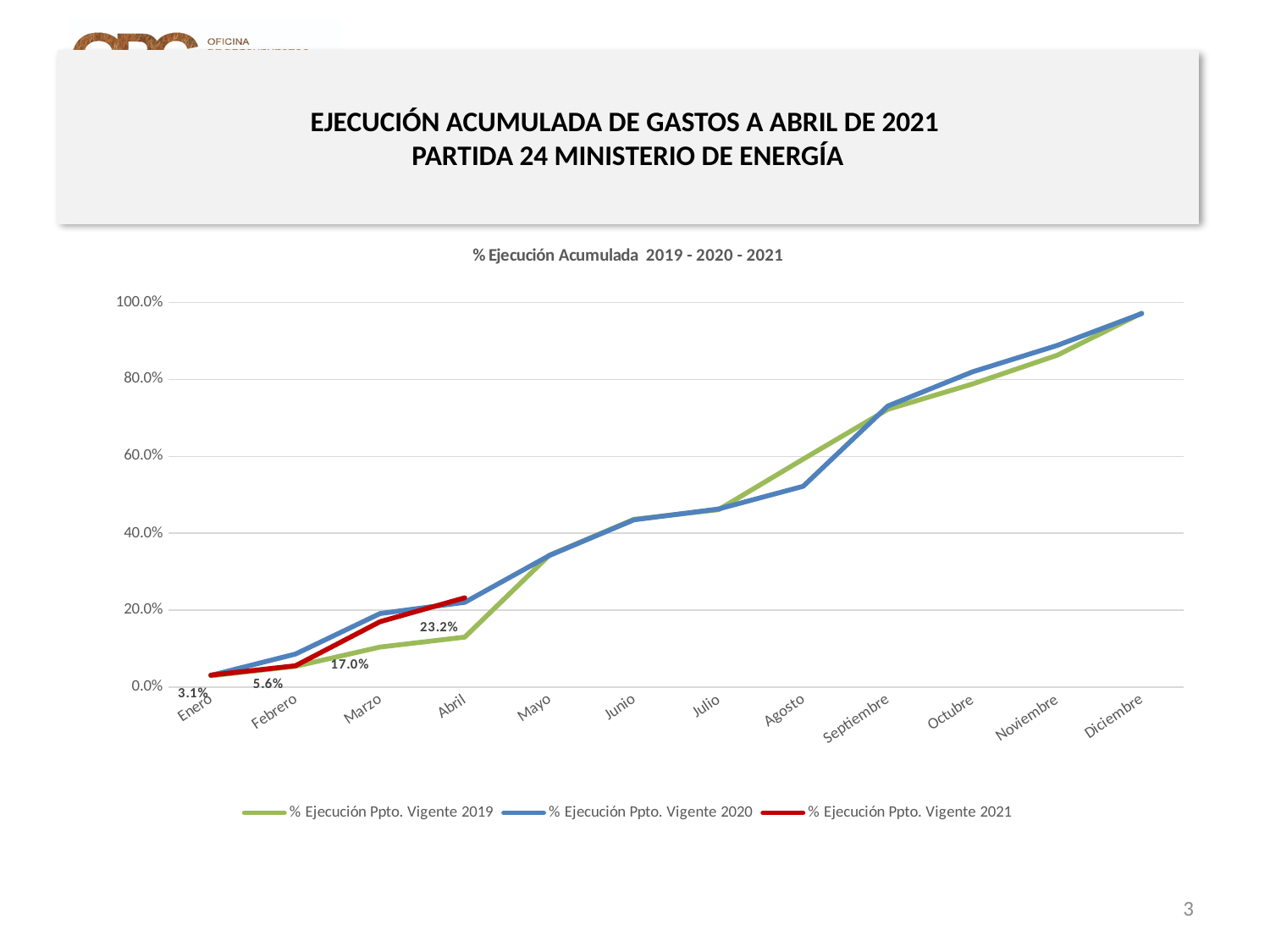
By how many percentage points did % Ejecución Ppto. Vigente 2021 increase from Marzo to Abril? 6.2 What kind of chart is shown on the slide? Line chart What is the value of % Ejecución Ppto. Vigente 2021 for Abril? 23.2% In which month does the % Ejecución Ppto. Vigente 2021 series reach its highest value? Abril Is the value for % Ejecución Ppto. Vigente 2019 in Abril greater or less than 20.0%? less What is the value of % Ejecución Ppto. Vigente 2021 for Marzo? 17.0% What is the value of % Ejecución Ppto. Vigente 2021 for Febrero? 5.6% What is the title of the chart? % Ejecución Acumulada 2019 - 2020 - 2021 Which series has the larger value in Abril, % Ejecución Ppto. Vigente 2019 or % Ejecución Ppto. Vigente 2020? % Ejecución Ppto. Vigente 2020 How many series does the legend list? 3 What is the value of % Ejecución Ppto. Vigente 2021 for Enero? 3.1% How many months are shown on the x axis? 12